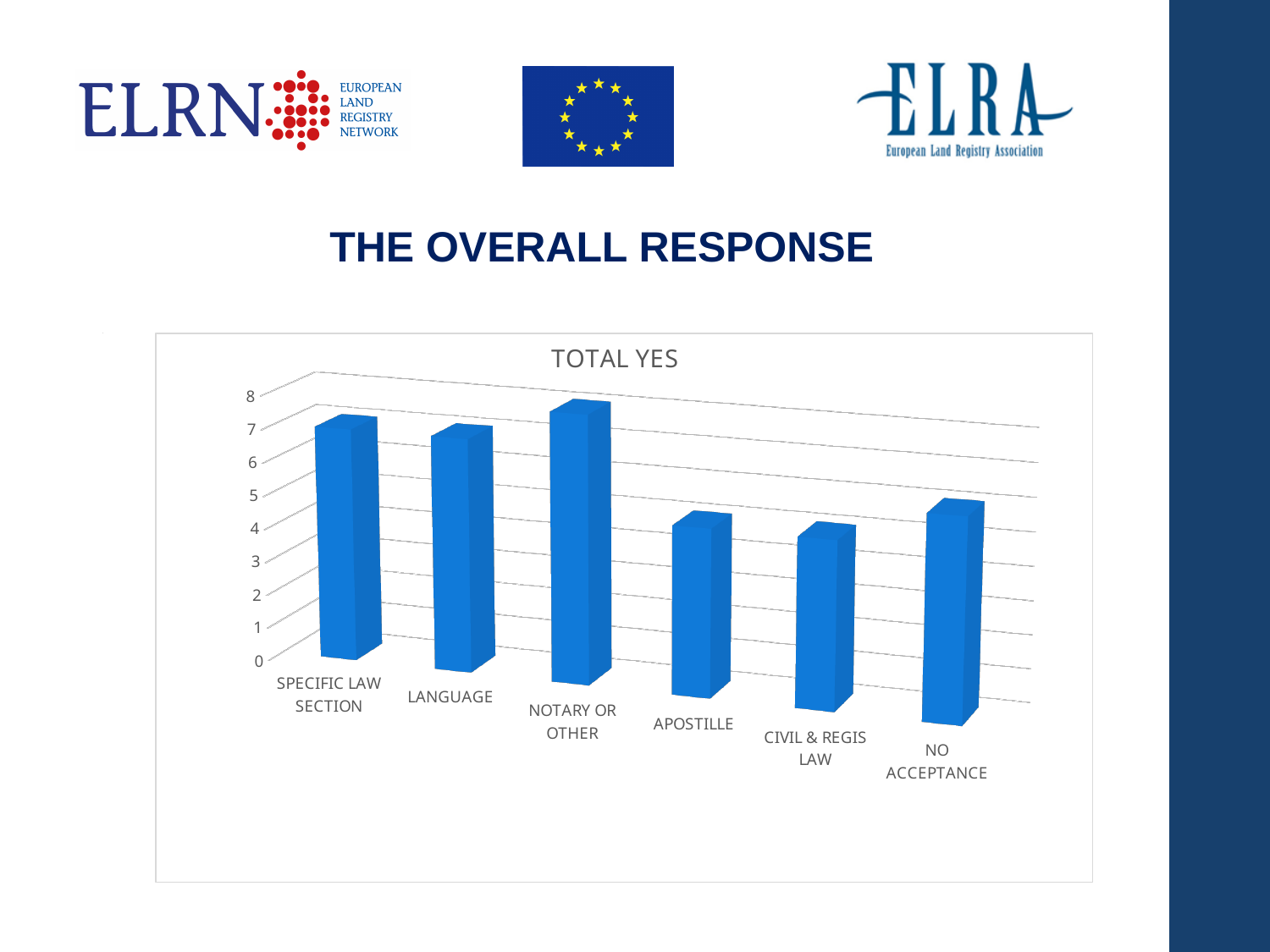
Is the value for SPECIFIC LAW SECTION greater or less than 5? greater Which is larger, the value for LANGUAGE or the value for NO ACCEPTANCE? LANGUAGE Which is larger, the value for SPECIFIC LAW SECTION or the value for APOSTILLE? SPECIFIC LAW SECTION What is the title of the chart? TOTAL YES What kind of chart is shown on the slide? Bar chart How many categories are shown on the x axis of the chart? 6 Is the value for APOSTILLE greater or less than 6? less Which category has the highest value in the chart? NOTARY OR OTHER Is the value for NOTARY OR OTHER greater or less than 6? greater What colour are the bars in the chart? Blue